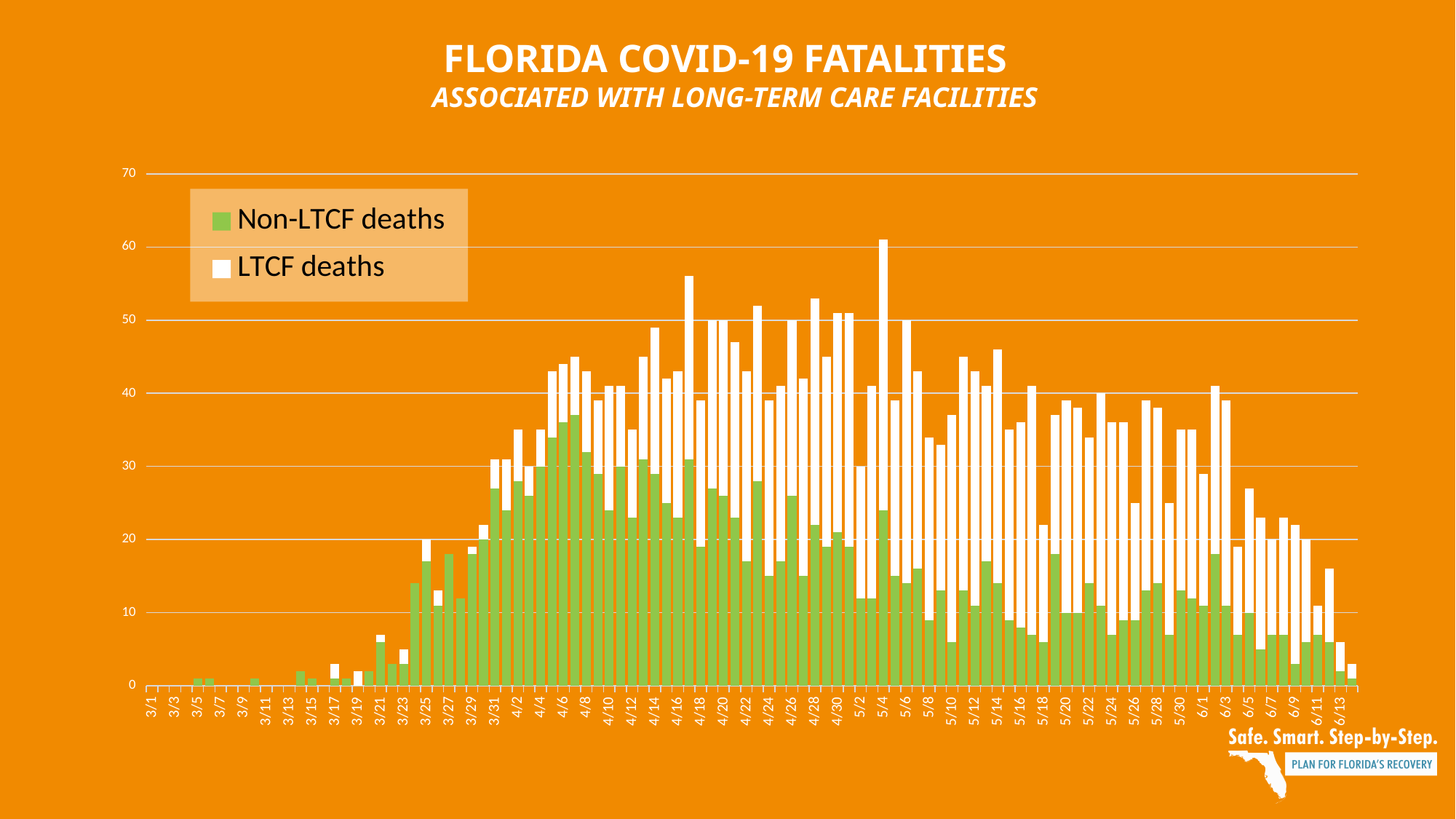
Which colour represents LTCF deaths in the chart? White How many series does the legend list? 2 Do the total daily fatalities generally rise or fall between 3/1 and 4/6? Rise What are the two series named in the legend? Non-LTCF deaths and LTCF deaths Is the total value for 6/13 greater or less than 10? less Do the total daily fatalities generally rise or fall between 5/4 and 6/13? Fall What kind of chart is shown on the slide? Stacked bar chart Is the total value for 4/6 greater or less than 30? greater Which date has the larger total bar, 4/6 or 3/21? 4/6 Is the total value for 5/4 greater or less than 50? greater On which date does the tallest stacked bar occur? 5/4